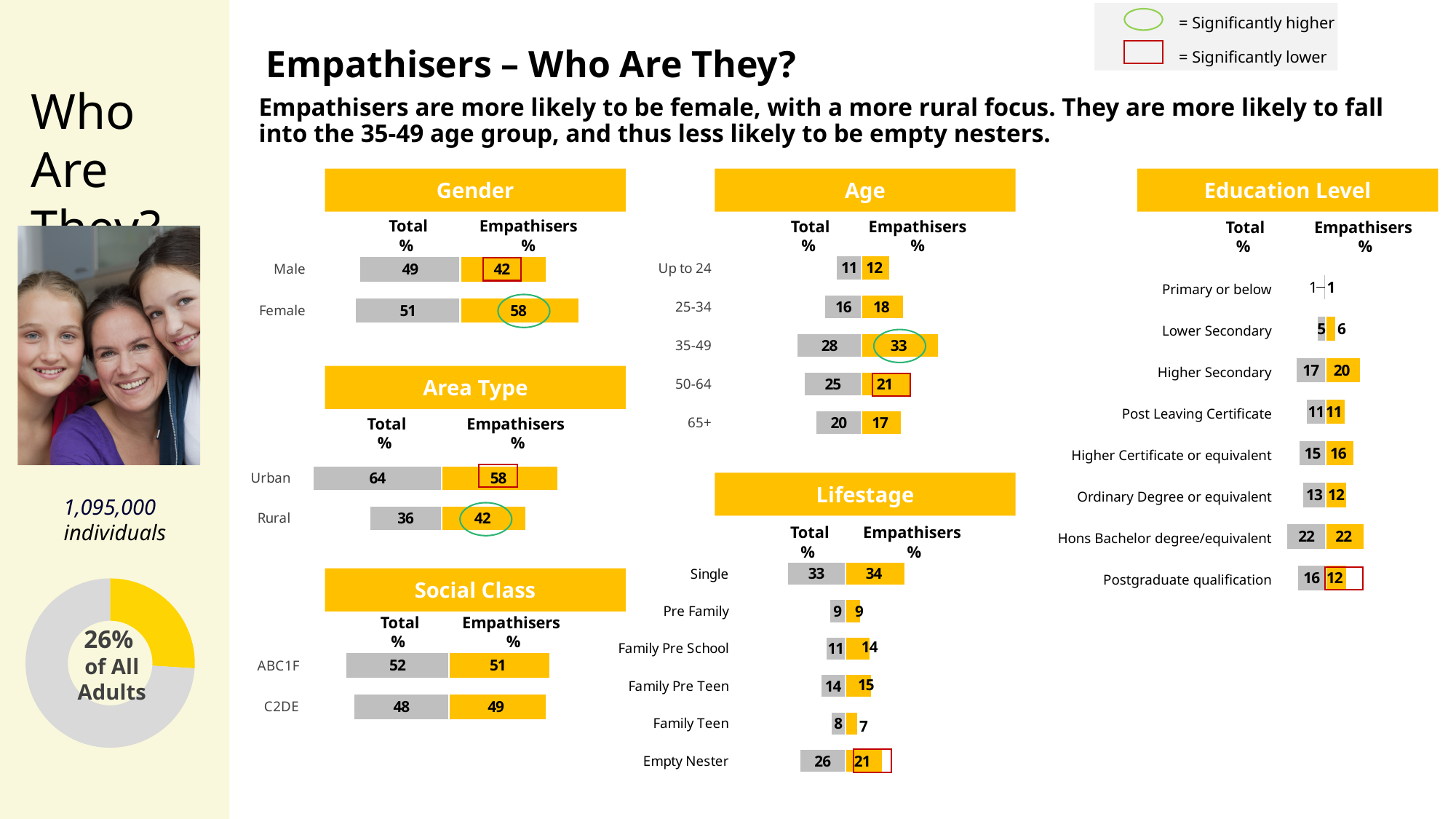
In the Education Level chart, what is the Empathisers % value for Postgraduate qualification? 12 In the Gender chart, what is the Total % value for Male? 49 In the Social Class chart, what is the Empathisers % value for C2DE? 49 How many lifestage categories are shown in the Lifestage chart? 6 In the Age chart, which age group has the lowest Total % value? Up to 24 In the Age chart, is the Empathisers % value for 50-64 larger or smaller than the Total % value for 50-64? smaller In the Education Level chart, which category has the highest Total % value? Hons Bachelor degree/equivalent In the Age chart, which age group has the highest Empathisers % value? 35-49 In the Lifestage chart, what is the Empathisers % value for Empty Nester? 21 In the Gender chart, what is the Empathisers % value for Female? 58 What share of all adults does the donut chart on the left show for Empathisers? 26% In the Area Type chart, what is the difference between the Total % and Empathisers % values for Rural? 6